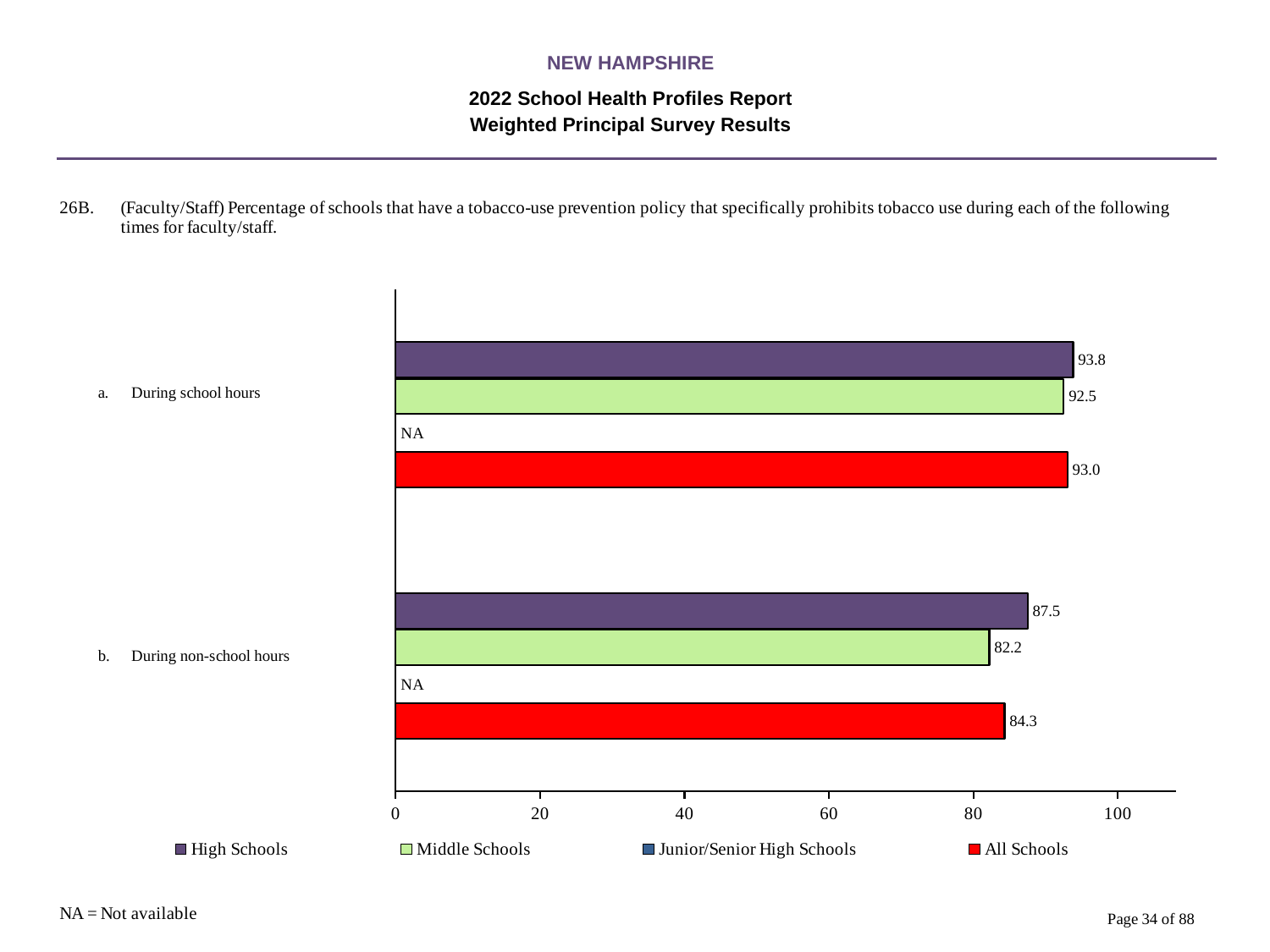
Which is larger for Middle Schools: 'During school hours' or 'During non-school hours'? During school hours What value is shown for Junior/Senior High Schools for 'During school hours'? NA What kind of chart is shown on the slide? Bar chart What colour are the All Schools bars? Red What is the difference between the High Schools values for 'During school hours' and 'During non-school hours'? 6.3 What is the value for Middle Schools for 'During non-school hours'? 82.2 Which series has the lowest value for 'During non-school hours'? Middle Schools What is the value for All Schools for 'During school hours'? 93.0 Which series has the highest value for 'During non-school hours'? High Schools What is the value for High Schools for 'During school hours'? 93.8 What is the value for All Schools for 'During non-school hours'? 84.3 How many series does the legend list? 4